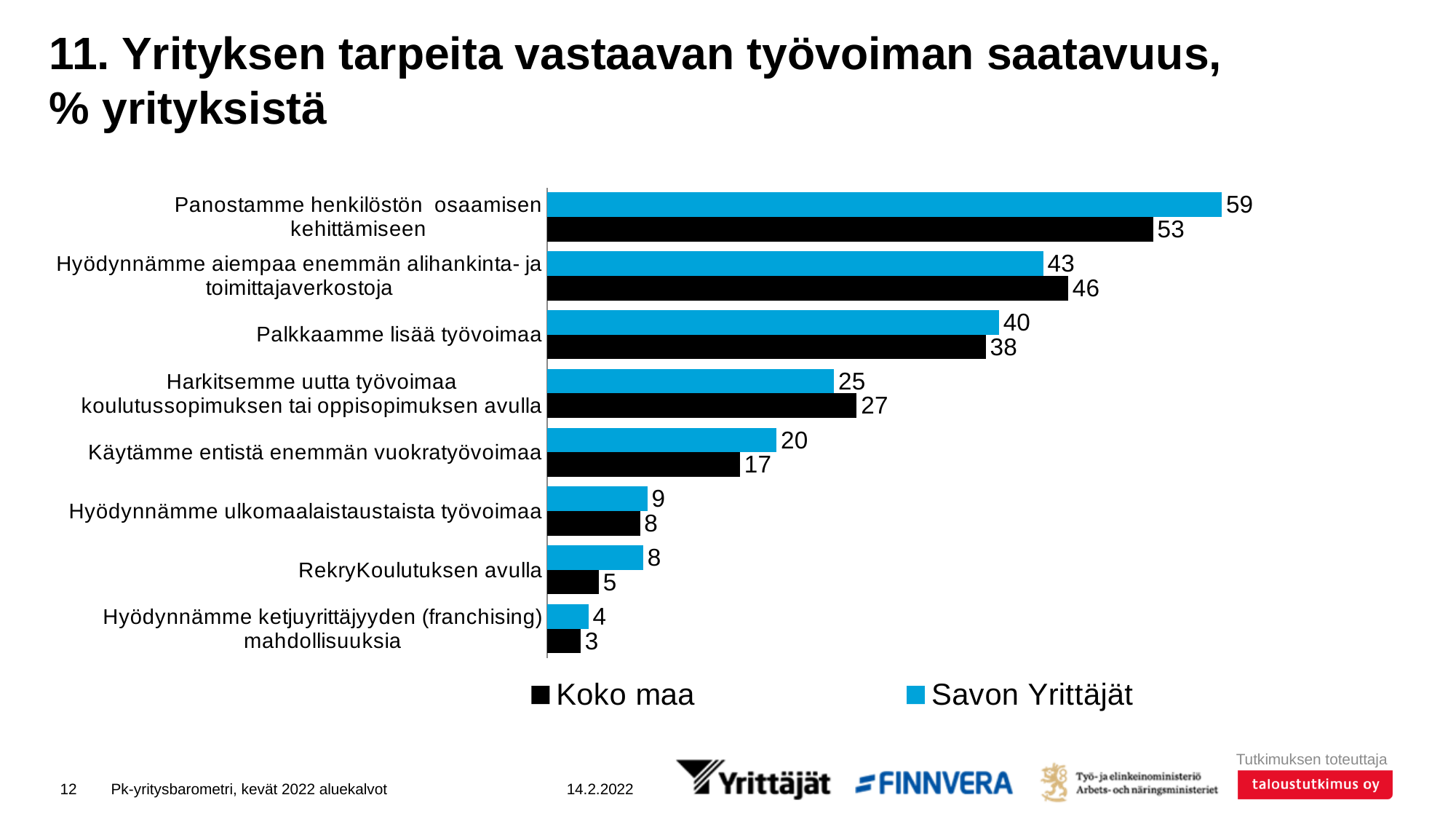
What is the difference between the Savon Yrittäjät and Koko maa values for 'Panostamme henkilöstön osaamisen kehittämiseen'? 6 What is the value for Koko maa for 'Palkkaamme lisää työvoimaa'? 38 What kind of chart is shown on the slide? Bar chart What is the value for Koko maa for 'Hyödynnämme aiempaa enemmän alihankinta- ja toimittajaverkostoja'? 46 How many categories are shown in the chart? 8 What is the value for Savon Yrittäjät for 'RekryKoulutuksen avulla'? 8 Which category has the lowest value for Koko maa? Hyödynnämme ketjuyrittäjyyden (franchising) mahdollisuuksia Which is larger for 'Harkitsemme uutta työvoimaa koulutussopimuksen tai oppisopimuksen avulla': Koko maa or Savon Yrittäjät? Koko maa What is the value for Savon Yrittäjät for 'Panostamme henkilöstön osaamisen kehittämiseen'? 59 Which colour represents Savon Yrittäjät in the chart? Blue Which category has the highest value for Savon Yrittäjät? Panostamme henkilöstön osaamisen kehittämiseen How many series does the legend list? 2